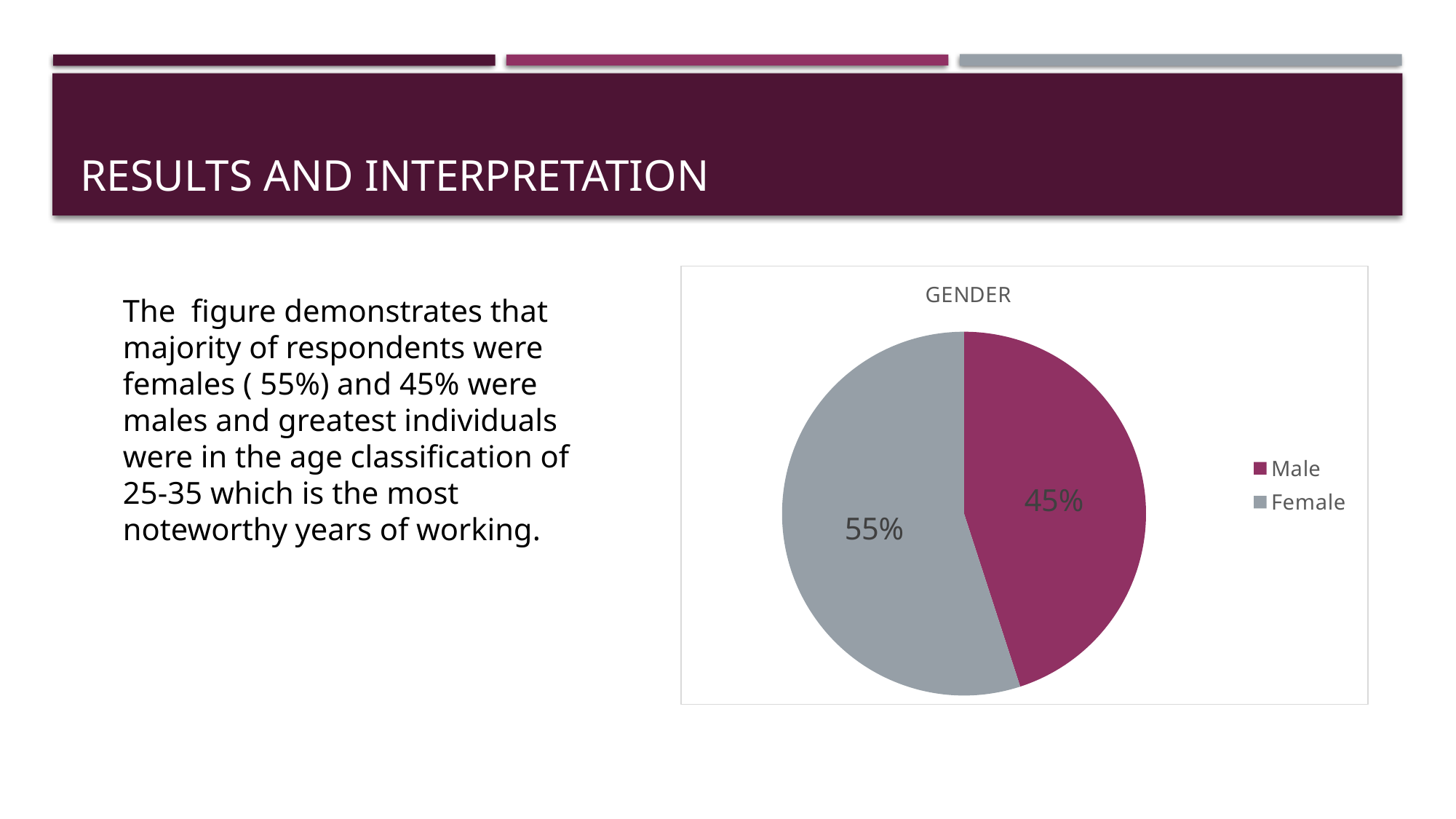
What is the total of the Male and Female shares? 100% What is the difference between the Female and Male shares? 10% What share of the pie is Male? 45% What kind of chart is shown on the slide? pie chart How many categories does the pie chart have? 2 Which is larger, the Male slice or the Female slice? Female What share of the pie is Female? 55% Which category has the largest slice of the pie? Female What colour is the Male slice in the pie chart? magenta Which category has the smallest slice of the pie? Male How many entries does the legend list? 2 What is the title of the chart? GENDER